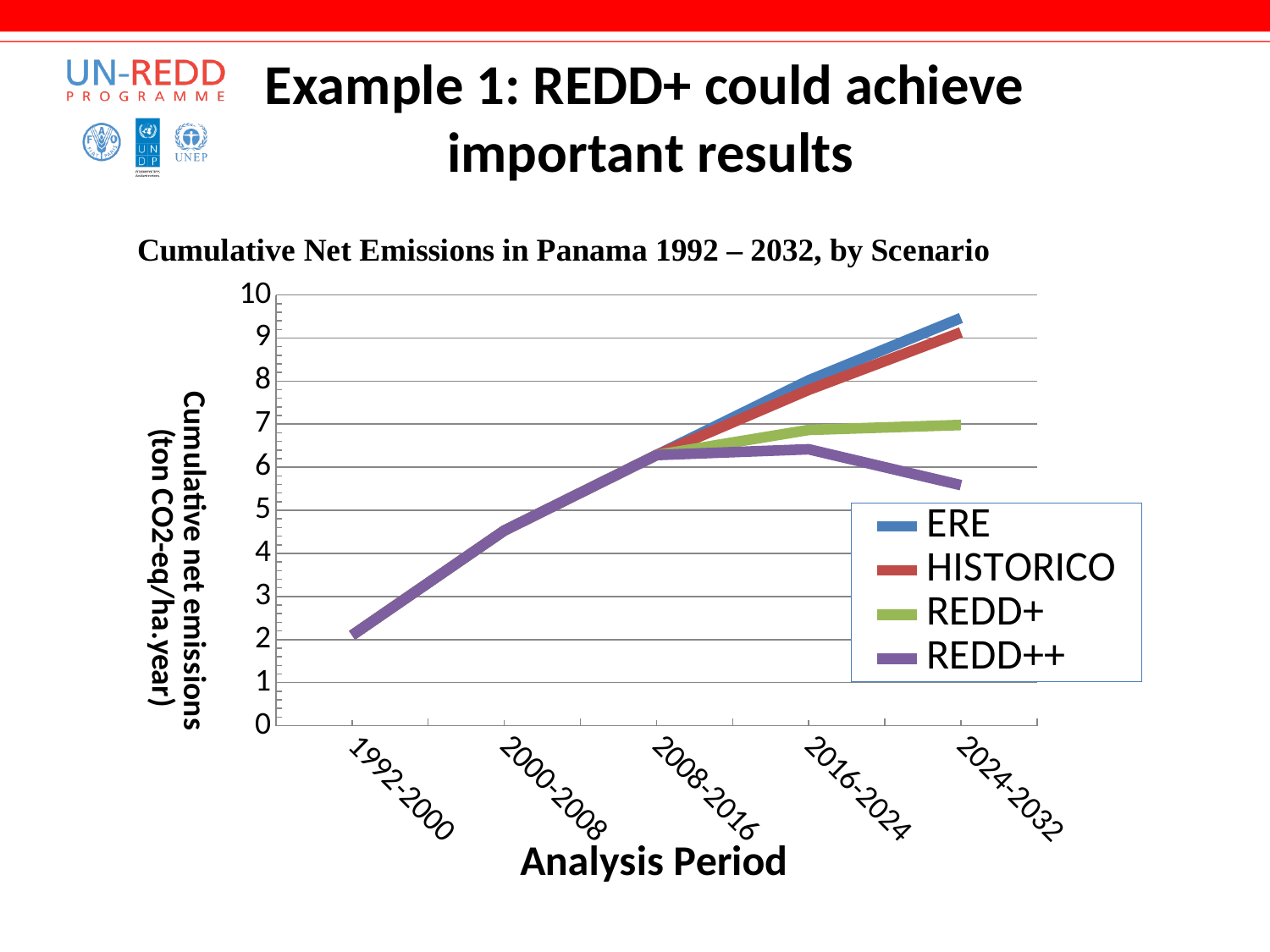
Which scenario has the lowest value in the 2024-2032 period? REDD++ What is the label of the x axis? Analysis Period Is the value for ERE in 2024-2032 greater or less than 9? greater In the 2024-2032 period, which is larger, REDD+ or REDD++? REDD+ Which scenario has the highest value in the 2024-2032 period? ERE What kind of chart is shown on the slide? line chart What is the title of the chart? Cumulative Net Emissions in Panama 1992 – 2032, by Scenario How many series does the legend list? 4 How many analysis periods are shown on the x axis? 5 Is the value for REDD+ in 2024-2032 greater or less than 8? less Does the REDD++ line rise or fall from 2016-2024 to 2024-2032? fall Is the value for REDD++ in 2024-2032 greater or less than 6? less